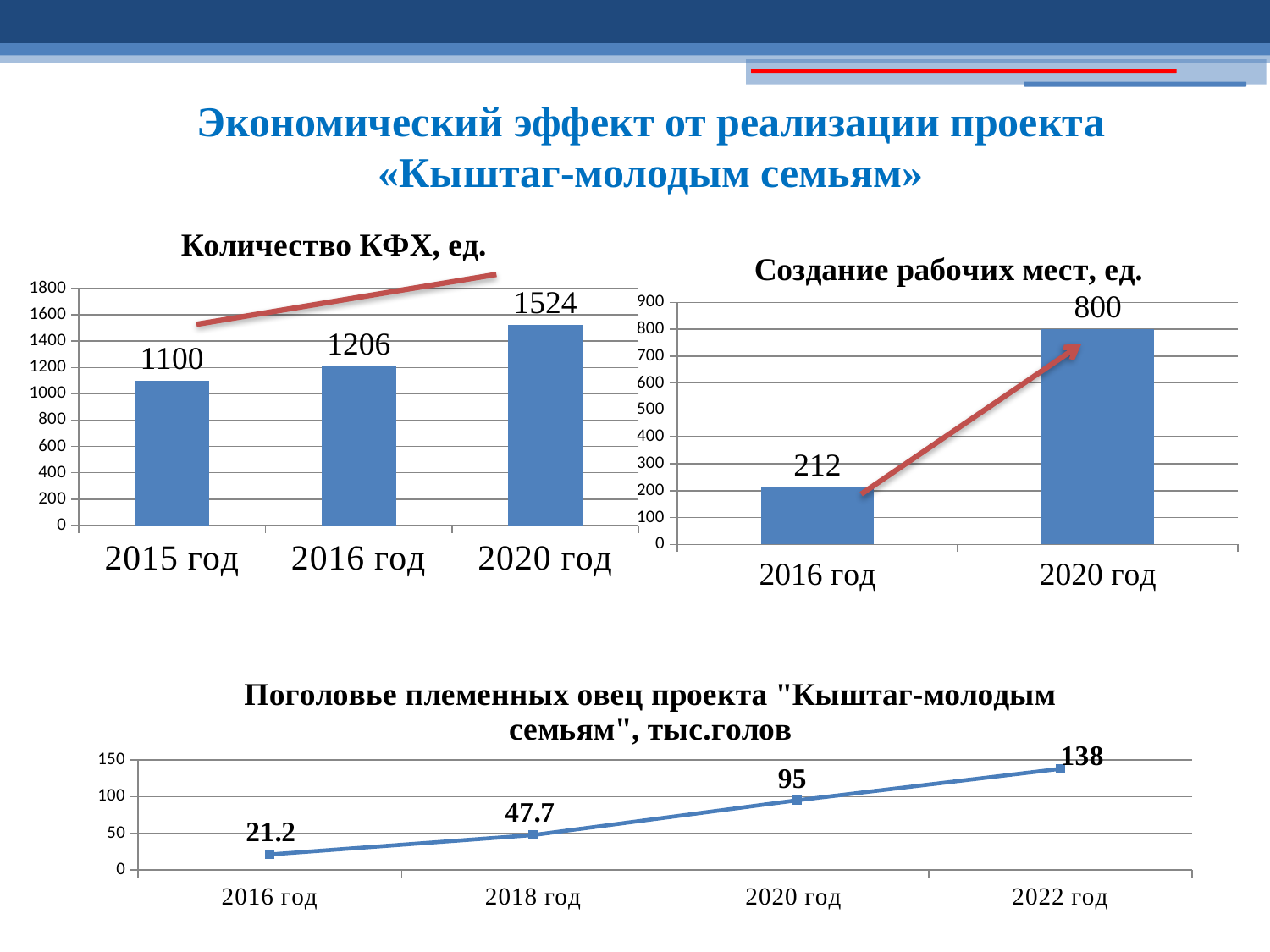
In the chart "Поголовье племенных овец проекта "Кыштаг-молодым семьям", тыс.голов", what is the value for 2018 год? 47.7 In the chart "Создание рабочих мест, ед.", what is the value for 2016 год? 212 What kind of chart is "Поголовье племенных овец проекта "Кыштаг-молодым семьям", тыс.голов"? line chart In the chart "Создание рабочих мест, ед.", what is the difference between the values for 2020 год and 2016 год? 588 In the chart "Количество КФХ, ед.", which year has the highest value? 2020 год In the chart "Количество КФХ, ед.", what is the difference between the values for 2020 год and 2015 год? 424 What kind of chart is "Создание рабочих мест, ед."? bar chart In the chart "Количество КФХ, ед.", what is the value for 2016 год? 1206 In the chart "Поголовье племенных овец проекта "Кыштаг-молодым семьям", тыс.голов", do the values rise or fall from 2016 год to 2022 год? rise In the chart "Количество КФХ, ед.", how many bars are plotted? 3 In the chart "Поголовье племенных овец проекта "Кыштаг-молодым семьям", тыс.голов", how many data points are plotted? 4 In the chart "Поголовье племенных овец проекта "Кыштаг-молодым семьям", тыс.голов", which year has the lowest value? 2016 год